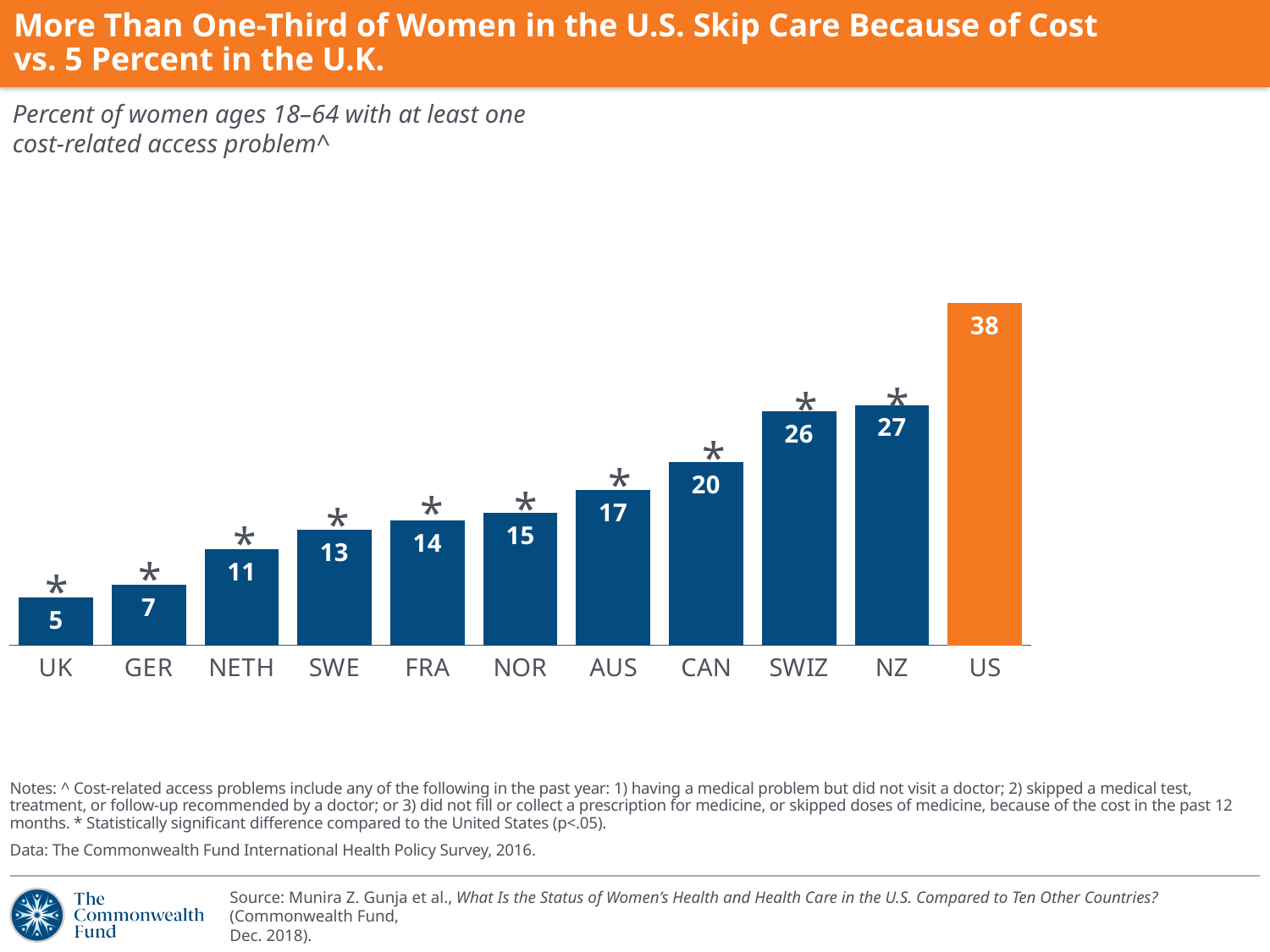
What is the difference between the values for the US and the UK? 33 Which country has the highest value? US What is the value for the US? 38 How many countries are shown in the chart? 11 What is the difference between the values for NZ and SWIZ? 1 Which has a larger value, FRA or NETH? FRA Which country has the lowest value? UK Which bar is shown in orange rather than blue? US What is the value for Sweden (SWE)? 13 Do the values rise or fall from left to right along the x axis? Rise What is the value for Canada (CAN)? 20 What kind of chart is shown on the slide? Bar chart